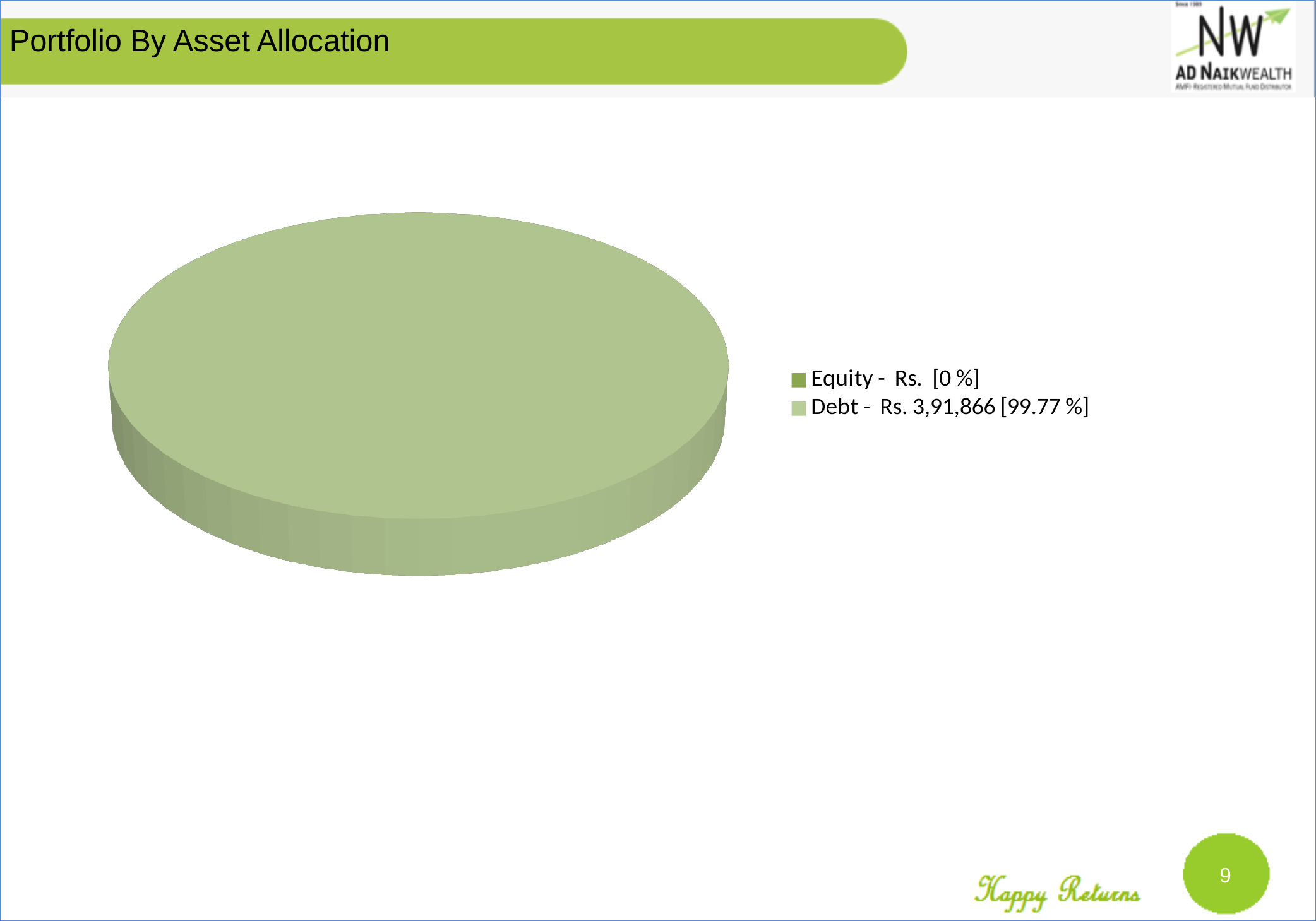
What share of the pie does Debt represent? 99.77 % Is the share for Debt greater or less than 50%? greater What is the title of the chart on the slide? Portfolio By Asset Allocation What share of the pie does Equity represent? 0 % What kind of chart is shown on the slide? pie chart Which is larger, the share for Equity or the share for Debt? Debt Which category has the smallest share of the pie? Equity What is the Rs. value shown for Debt in the legend? Rs. 3,91,866 Which legend entry is shown with the darker green colour? Equity How many categories does the legend of the pie chart list? 2 Which category has the largest share of the pie? Debt